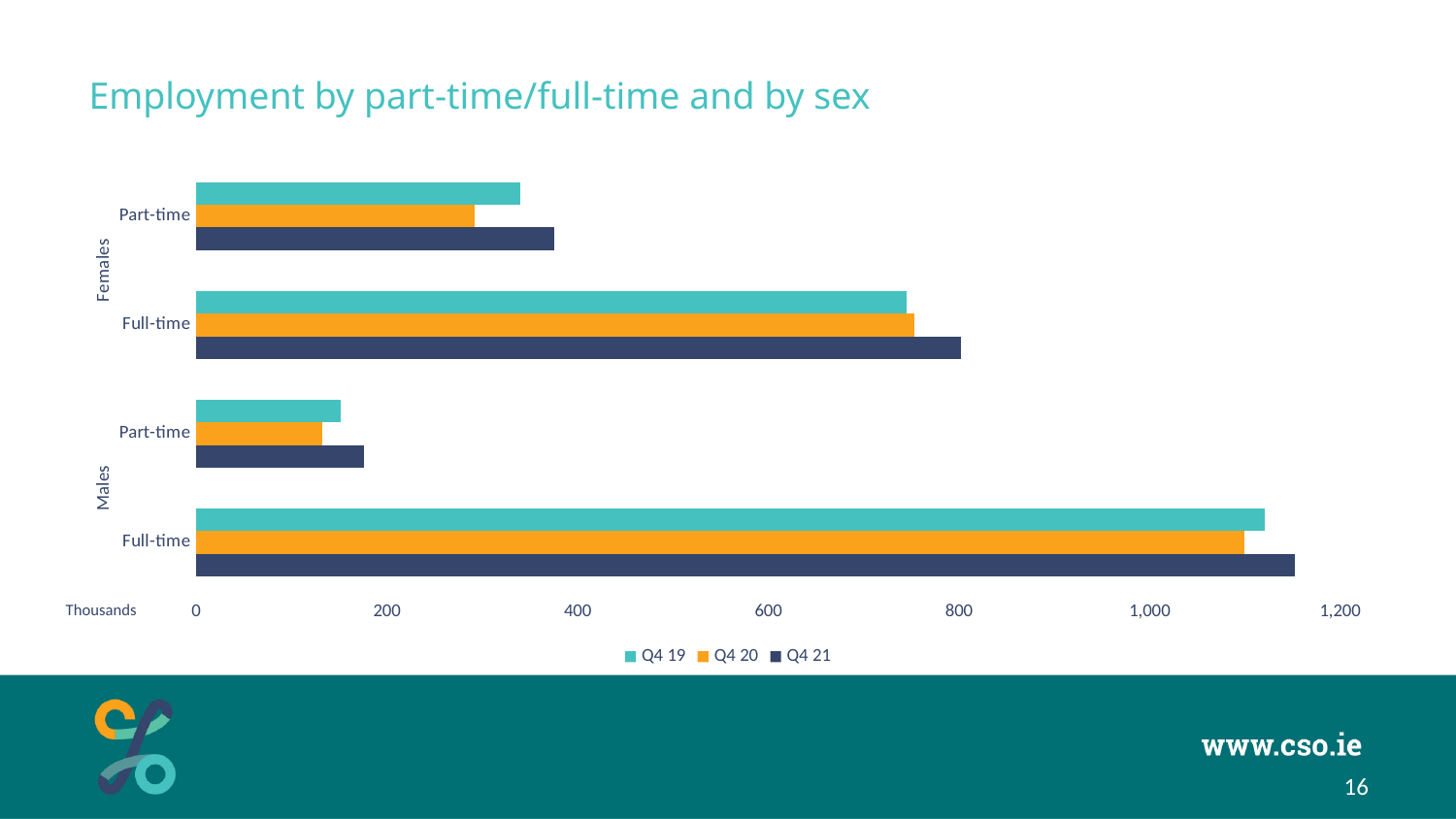
What unit is shown for the horizontal axis? Thousands For Females Part-time, which is larger: the Q4 19 value or the Q4 20 value? Q4 19 Is the Q4 21 value for Females Part-time greater or less than 400? less Is the Q4 20 value for Males Part-time greater or less than 200? less Which category has the highest Q4 21 value? Males Full-time What kind of chart is shown on the slide? Bar chart Is the Q4 21 value for Females Full-time greater or less than 600? greater For Males Part-time, which is larger: the Q4 20 value or the Q4 21 value? Q4 21 How many series does the legend list? 3 Which category has the lowest Q4 21 value? Males Part-time How many categories (sex/working-time groups) are plotted on the chart? 4